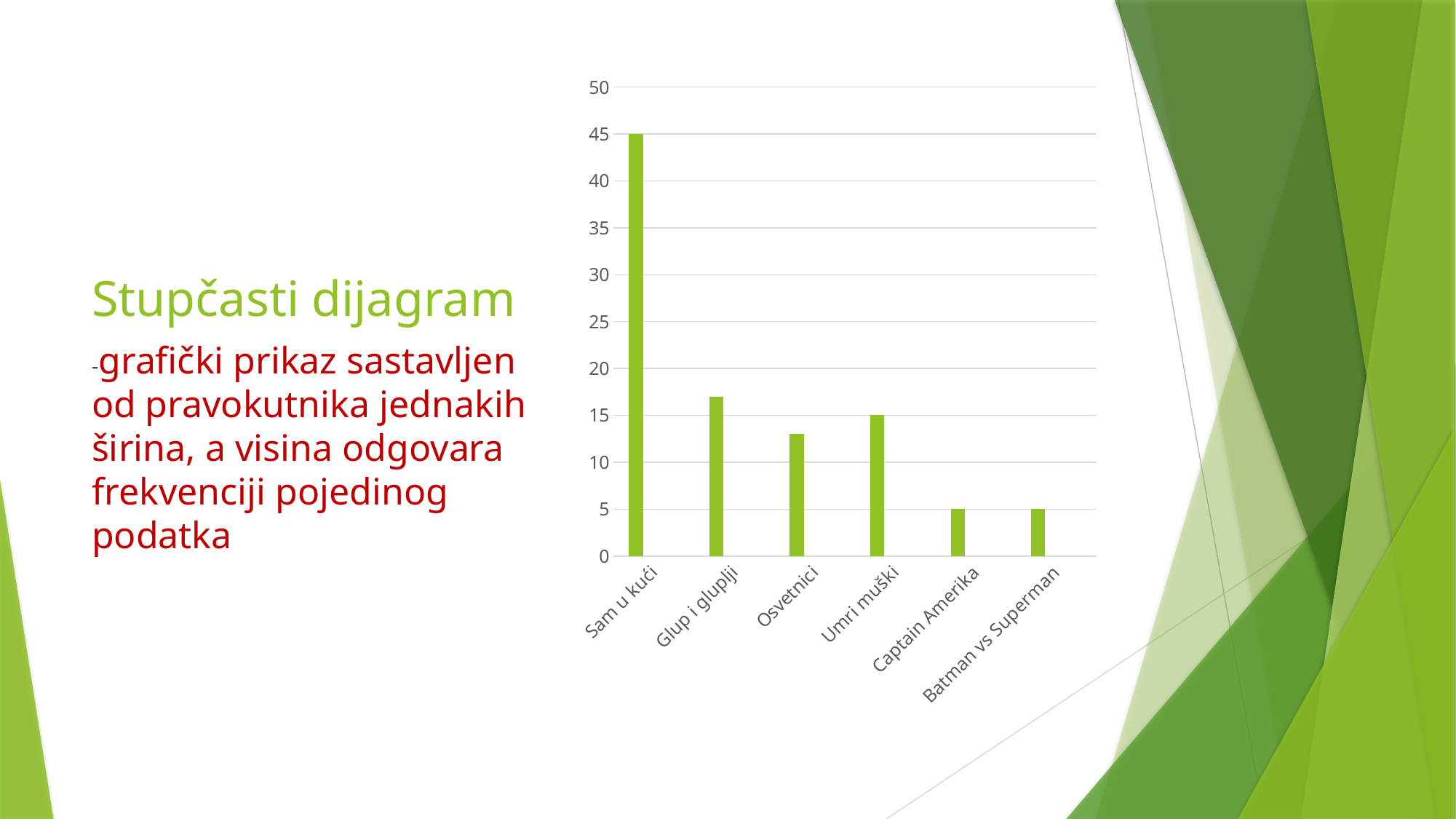
How many categories are plotted on the chart? 6 What is the difference between the value for Sam u kući and the value for Umri muški? 30 What is the value for Captain Amerika? 5 What kind of chart is shown on the slide? bar chart Is the value for Glup i gluplji greater or less than 20? less What is the value for Umri muški? 15 What colour are the bars on the chart? green What is the value for Batman vs Superman? 5 Is the value for Osvetnici greater or less than 15? less What is the value for Sam u kući? 45 Which category has the highest value on the chart? Sam u kući Which is larger, the value for Glup i gluplji or the value for Osvetnici? Glup i gluplji